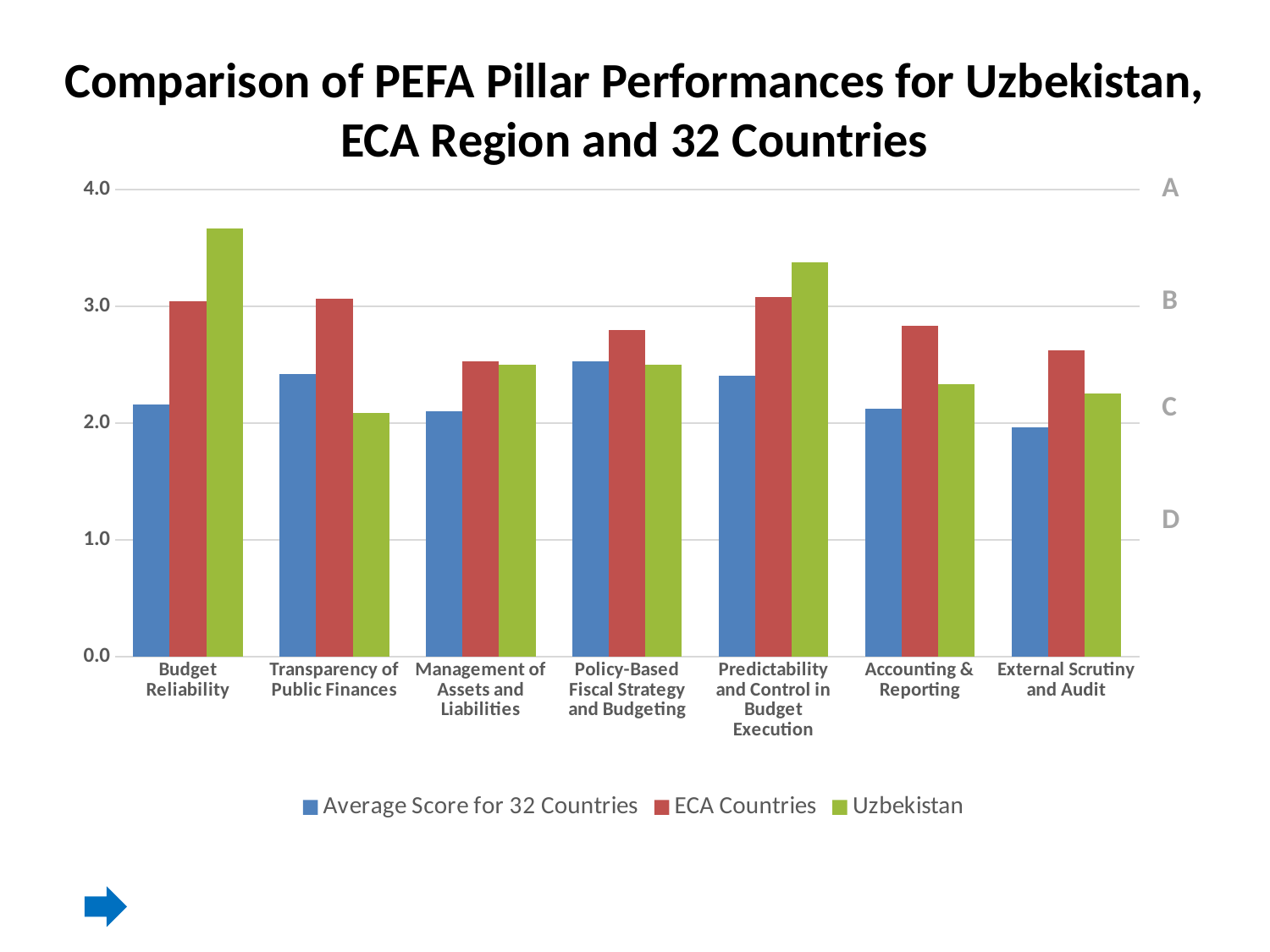
Which colour represents Uzbekistan in the legend? Green For which pillar is the Uzbekistan score lowest? Transparency of Public Finances Is the Uzbekistan value for Budget Reliability greater or less than 3.0? greater How many series does the legend list? 3 For Predictability and Control in Budget Execution, which is larger: the Uzbekistan score or the Average Score for 32 Countries? Uzbekistan What kind of chart is shown on the slide? Bar chart Is the ECA Countries value for Accounting & Reporting greater or less than 3.0? less For which pillar is the Uzbekistan score highest? Budget Reliability For Transparency of Public Finances, which is larger: the ECA Countries score or the Uzbekistan score? ECA Countries For which pillar is the Average Score for 32 Countries lowest? External Scrutiny and Audit How many PEFA pillar categories are shown on the x axis? 7